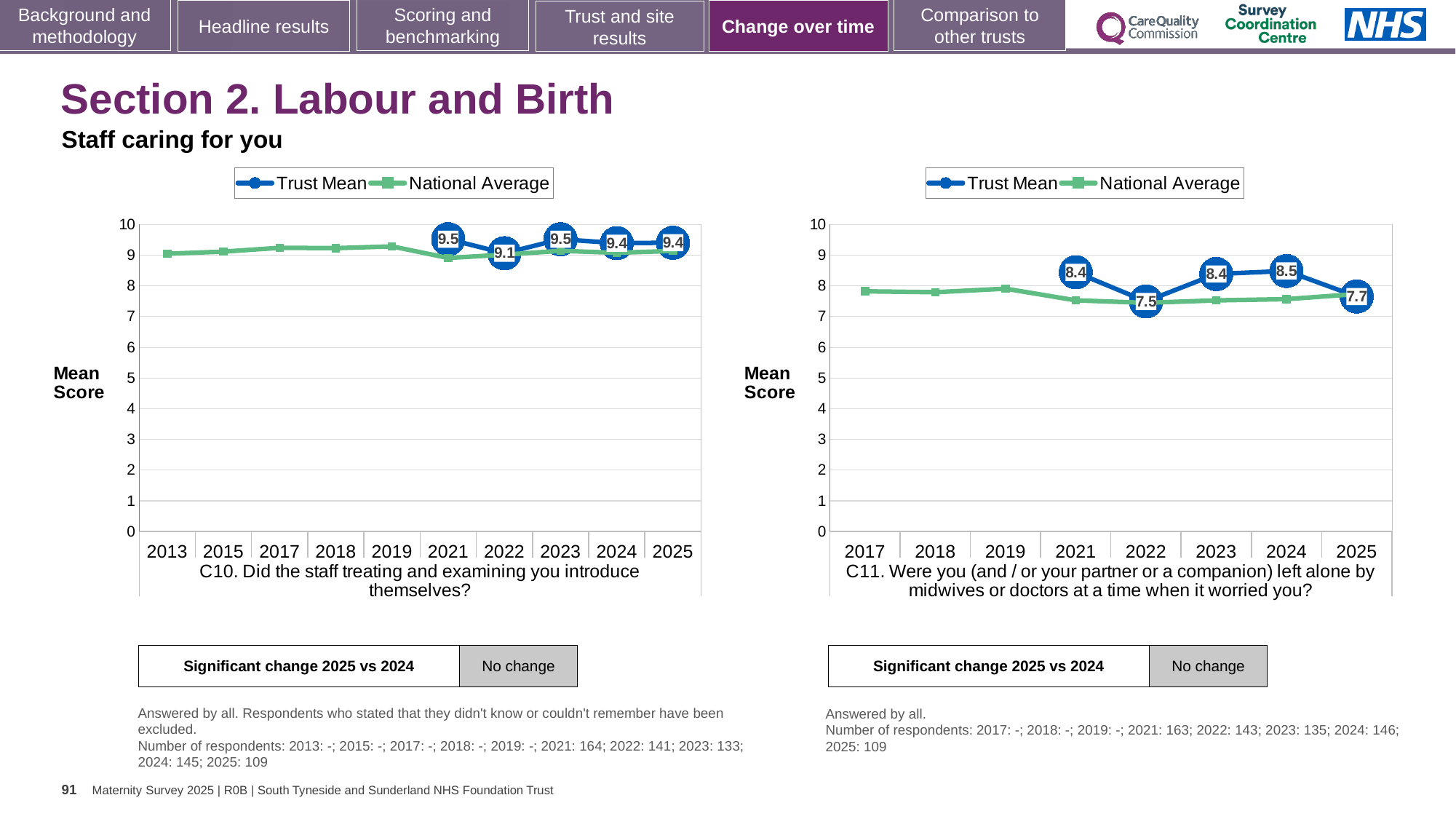
In the right chart (C11), which year has the lowest Trust Mean score? 2022 In the left chart (C10), which year has the lowest Trust Mean score? 2022 In the right chart (C11), what is the Trust Mean score for 2025? 7.7 In the right chart (C11), what is the difference between the Trust Mean scores for 2024 and 2025? 0.8 In the right chart (C11), what is the Trust Mean score for 2024? 8.5 In the right chart (C11), is the National Average value for 2017 greater or less than 7? greater What type of chart is the left chart (C10)? line chart In the left chart (C10), what is the Trust Mean score for 2025? 9.4 In the left chart (C10), is the Trust Mean score for 2021 higher or lower than for 2022? higher How many years are shown on the x axis of the right chart (C11)? 8 How many series does the legend of the left chart (C10) list? 2 In the left chart (C10), what is the Trust Mean score for 2022? 9.1